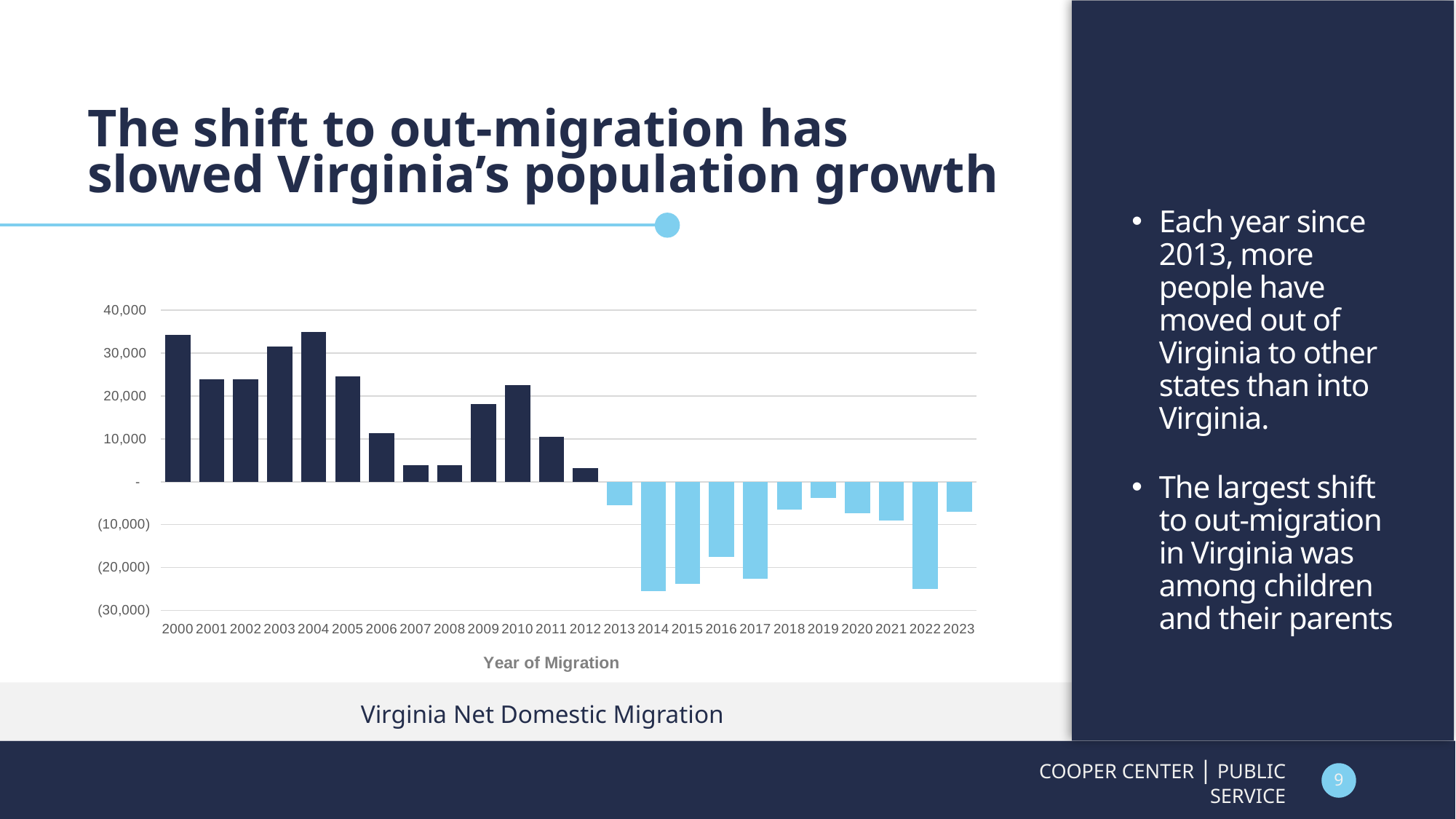
What is the title shown beneath the chart? Virginia Net Domestic Migration What is the title of the x axis of the chart? Year of Migration Is the value for 2019 greater or less than (10,000)? greater Is the value for 2014 greater or less than (20,000)? less Is the value for 2000 greater or less than 30,000? greater Do the values generally rise or fall from 2000 to 2023? fall Which year has the larger value, 2010 or 2011? 2010 Which year has the larger value, 2000 or 2001? 2000 What kind of chart is shown on the slide? bar chart How many years are plotted on the x axis of the chart? 24